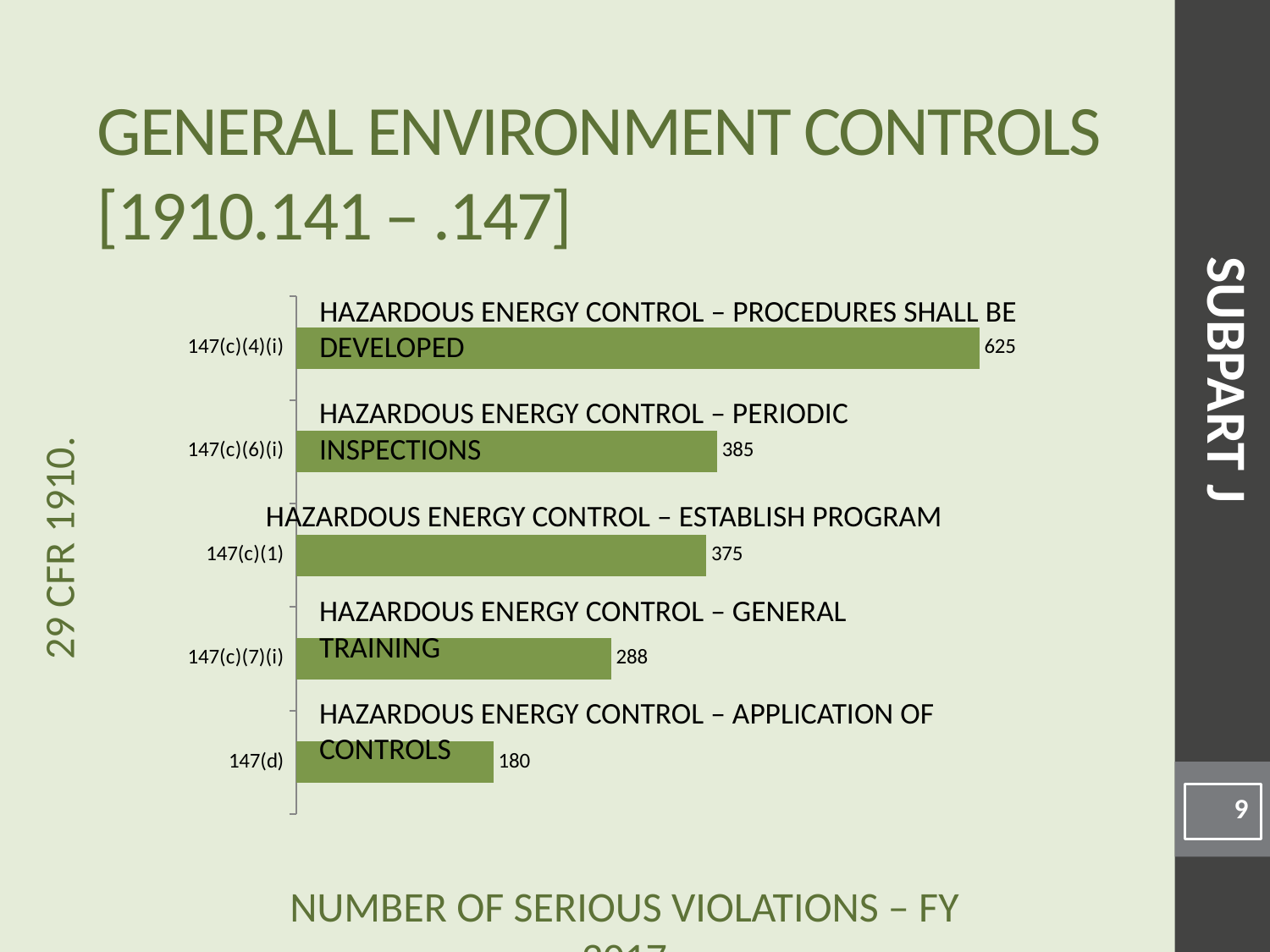
What is the difference between the values for 147(c)(4)(i) and 147(c)(6)(i)? 240 What is the number of serious violations for 147(c)(6)(i)? 385 How many categories are shown in the chart? 5 Which category has the lowest number of serious violations? 147(d) What is the number of serious violations for 147(c)(4)(i)? 625 What is the difference between the values for 147(c)(7)(i) and 147(d)? 108 Which has a larger value, 147(c)(1) or 147(c)(7)(i)? 147(c)(1) What is the number of serious violations for 147(c)(7)(i)? 288 Which category has the highest number of serious violations? 147(c)(4)(i) What kind of chart is shown on the slide? Bar chart What is the number of serious violations for 147(d)? 180 What is the number of serious violations for 147(c)(1)? 375